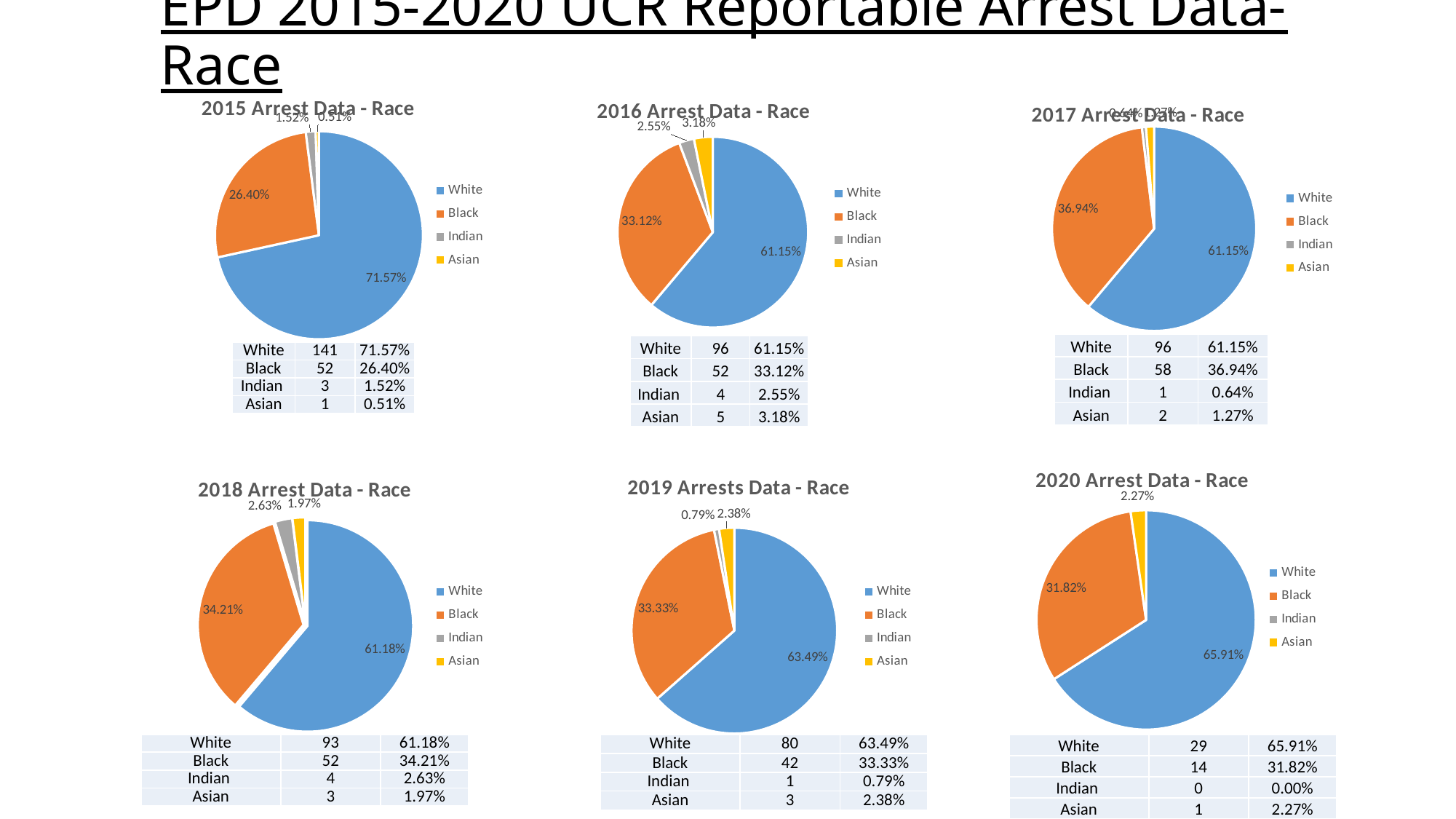
What is the title of the chart in the bottom-middle position of the slide? 2019 Arrests Data - Race In the 2015 Arrest Data - Race chart, what percentage is shown for White? 71.57% How many categories does the legend of the 2015 Arrest Data - Race chart list? 4 In the 2018 Arrest Data - Race chart, which is larger, the Indian slice or the Asian slice? Indian In the 2016 Arrest Data - Race chart, what is the difference in percentage points between the White and Black slices? 28.03% In the 2020 Arrest Data - Race chart, which category has the largest slice? White In the 2016 Arrest Data - Race chart, which category has the smallest slice? Indian In the 2020 Arrest Data - Race chart, what percentage is shown for Asian? 2.27% What kind of chart is the 2018 Arrest Data - Race chart? Pie chart How many charts are shown on the slide? 6 In the 2017 Arrest Data - Race chart, what percentage is shown for Black? 36.94% In the 2019 Arrests Data - Race chart, which is larger, the Black slice or the Indian slice? Black